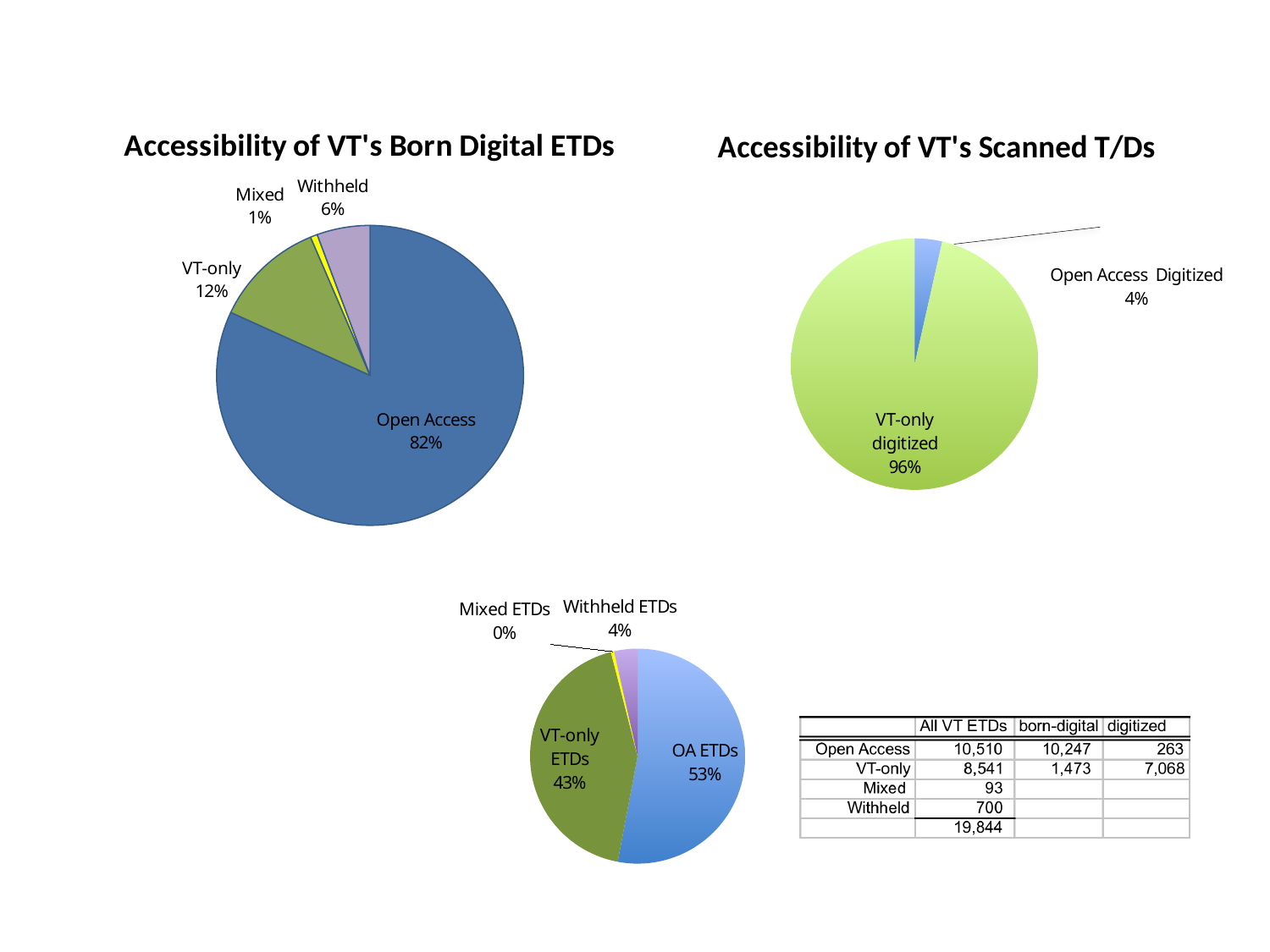
In the 'Accessibility of VT's Scanned T/Ds' chart, what percentage is labelled for Open Access Digitized? 4% In the 'Accessibility of VT's Born Digital ETDs' chart, what percentage is labelled for VT-only? 12% In the 'Accessibility of VT's Born Digital ETDs' chart, what is the difference in percentage points between Withheld and Mixed? 5 In the 'Accessibility of VT's Born Digital ETDs' chart, which category has the smallest slice? Mixed In the bottom pie chart, which is larger, OA ETDs or VT-only ETDs? OA ETDs In the bottom pie chart, what percentage is labelled for Withheld ETDs? 4% In the bottom pie chart, what percentage is labelled for OA ETDs? 53% What kind of chart is 'Accessibility of VT's Scanned T/Ds'? pie chart In the bottom pie chart, what is the difference in percentage points between OA ETDs and VT-only ETDs? 10 In the 'Accessibility of VT's Scanned T/Ds' chart, what share of the pie is VT-only digitized? 96% In the 'Accessibility of VT's Born Digital ETDs' chart, what share of the pie is Open Access? 82% In the 'Accessibility of VT's Born Digital ETDs' chart, how many slices does the pie have? 4